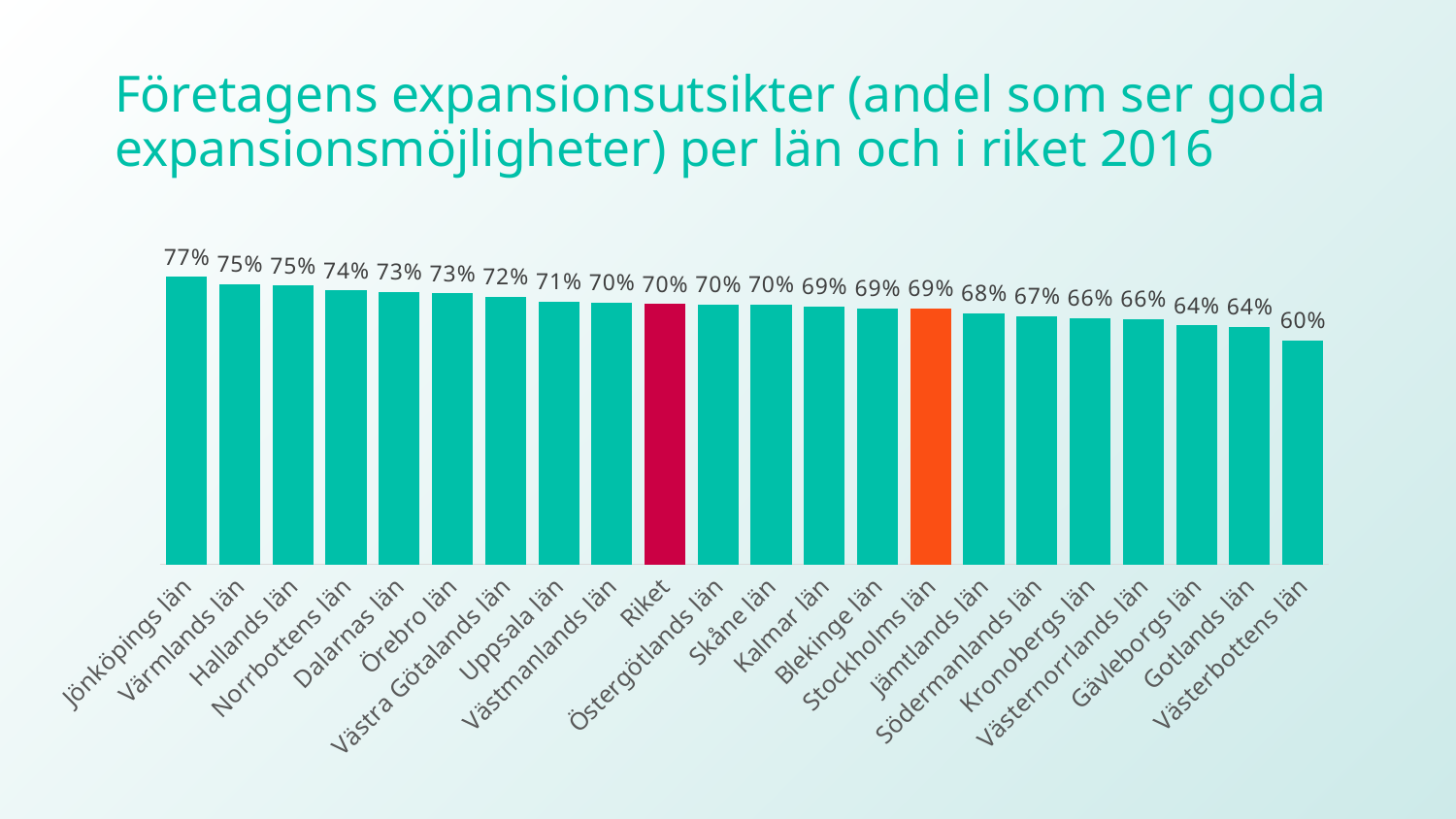
Which category has the highest value? Jönköpings län What is the difference between the values for Jönköpings län and Västerbottens län? 17% What is the value for Stockholms län? 69% What is the value for Riket? 70% What kind of chart is shown on the slide? Bar chart What is the difference between the values for Riket and Stockholms län? 1% What is the value for Västerbottens län? 60% How many categories are shown in the chart? 22 Which category has the lowest value? Västerbottens län Which is larger, the value for Norrbottens län or the value for Gotlands län? Norrbottens län What is the value for Jönköpings län? 77% Do the values rise or fall from left to right along the x axis? Fall